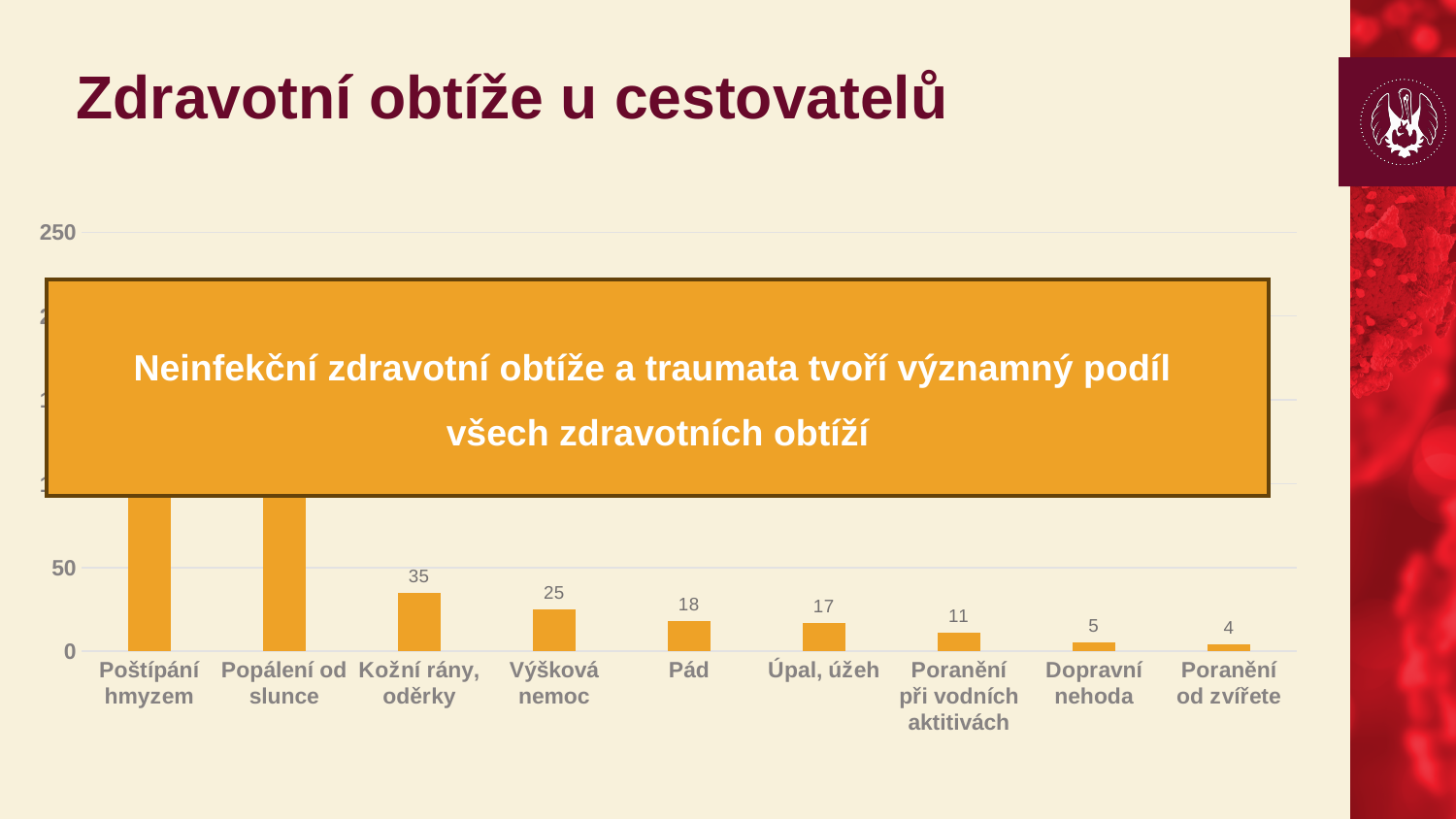
What is the value for Poranění od zvířete? 4 What is the value for Výšková nemoc? 25 What is the value for Pád? 18 What kind of chart is shown on the slide? bar chart What is the difference between the values for Kožní rány, oděrky and Výšková nemoc? 10 What is the value for Kožní rány, oděrky? 35 What is the value for Poranění při vodních aktivitách? 11 Which category has the lowest value? Poranění od zvířete Which is larger, the value for Pád or the value for Dopravní nehoda? Pád How many categories are shown on the x axis? 9 Is the value for Poštípání hmyzem greater or less than 50? greater What is the difference between the values for Poranění při vodních aktivitách and Dopravní nehoda? 6